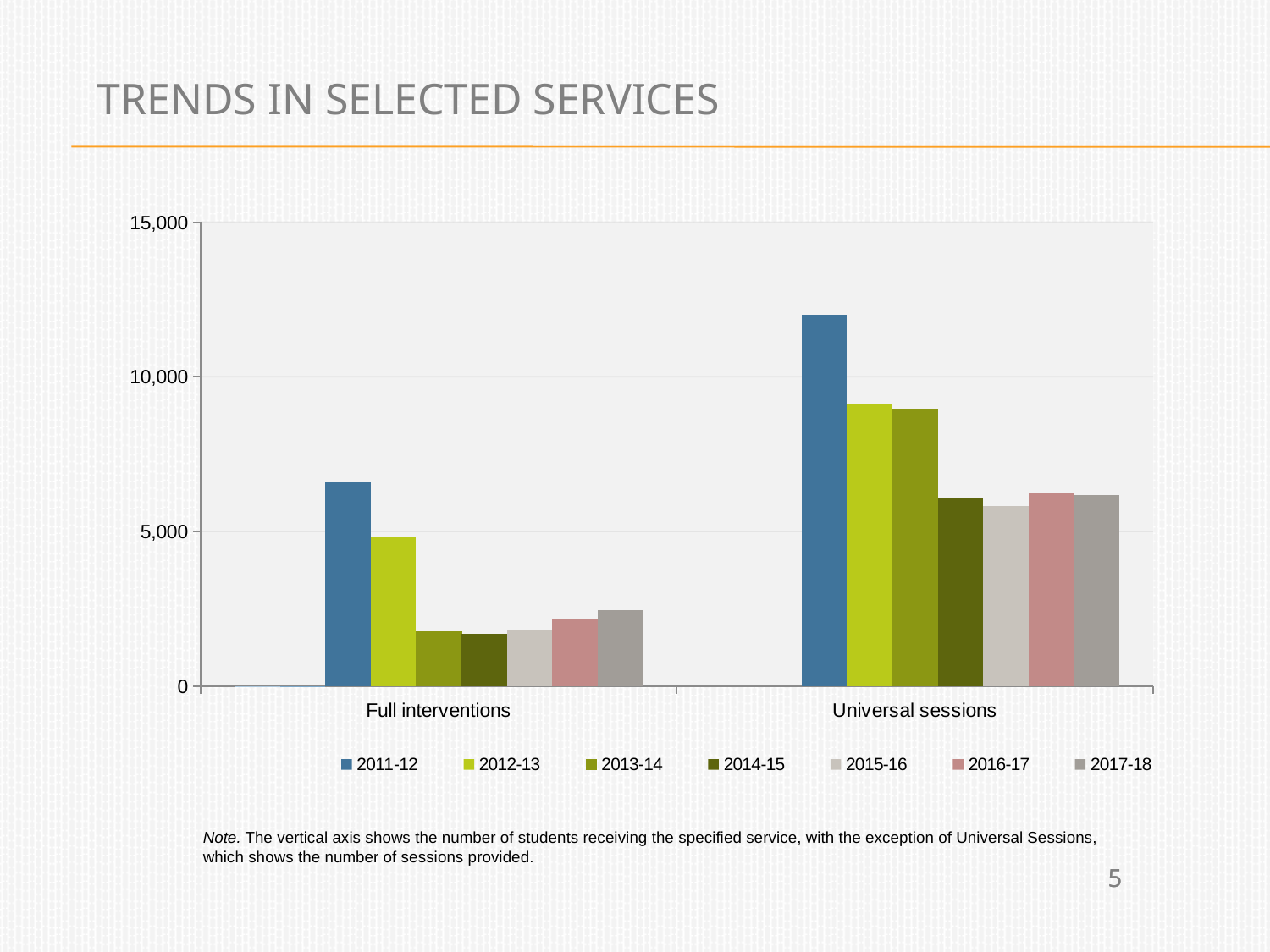
Which year has the highest value for Universal sessions? 2011-12 Is the 2017-18 value for Full interventions greater or less than 5,000? less For 2017-18, which category has the larger value: Full interventions or Universal sessions? Universal sessions For Full interventions, which is larger: the 2011-12 value or the 2012-13 value? 2011-12 How many categories are shown on the x axis of the chart? 2 What kind of chart is shown on the slide? bar chart What is the title of the slide containing the chart? TRENDS IN SELECTED SERVICES Is the 2011-12 value for Full interventions greater or less than 5,000? greater Which year has the highest value for Full interventions? 2011-12 Is the 2012-13 value for Universal sessions greater or less than 10,000? less How many series does the chart's legend list? 7